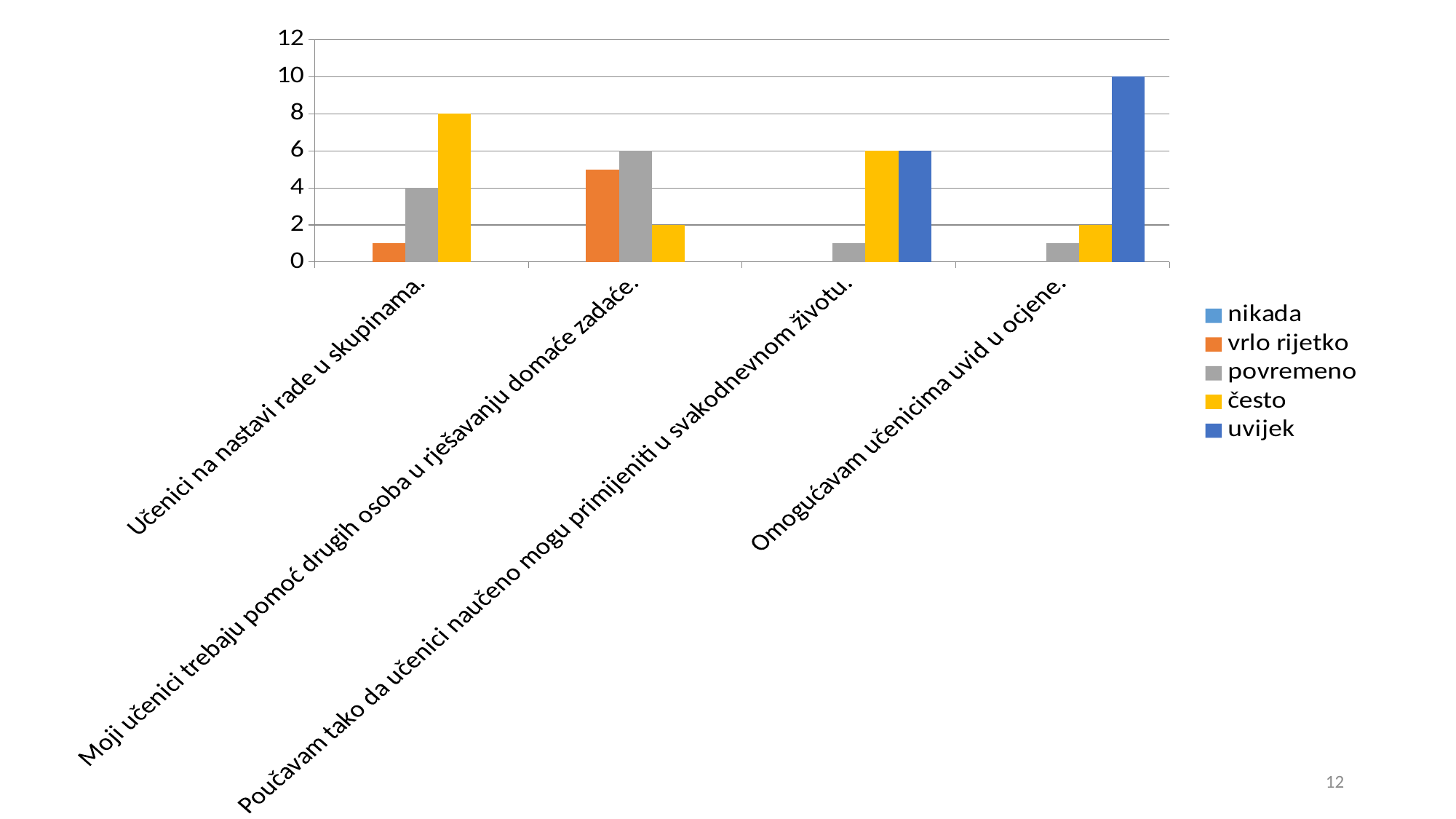
What is the value of "povremeno" for "Moji učenici trebaju pomoć drugih osoba u rješavanju domaće zadaće."? 6 What kind of chart is shown on the slide? bar chart Which series has the highest value for "Omogućavam učenicima uvid u ocjene."? uvijek What is the difference between the "često" value for "Učenici na nastavi rade u skupinama." and the "često" value for "Moji učenici trebaju pomoć drugih osoba u rješavanju domaće zadaće."? 6 How many series does the legend list? 5 What is the value of "uvijek" for "Omogućavam učenicima uvid u ocjene."? 10 What is the value of "često" for "Učenici na nastavi rade u skupinama."? 8 How many categories are shown on the x axis? 4 Is the value of "vrlo rijetko" for "Učenici na nastavi rade u skupinama." greater or less than 2? less Which is larger: the "povremeno" value for "Učenici na nastavi rade u skupinama." or the "često" value for "Omogućavam učenicima uvid u ocjene."? povremeno for Učenici na nastavi rade u skupinama. Is the value of "vrlo rijetko" for "Moji učenici trebaju pomoć drugih osoba u rješavanju domaće zadaće." greater or less than 4? greater What is the value of "često" for "Poučavam tako da učenici naučeno mogu primijeniti u svakodnevnom životu."? 6